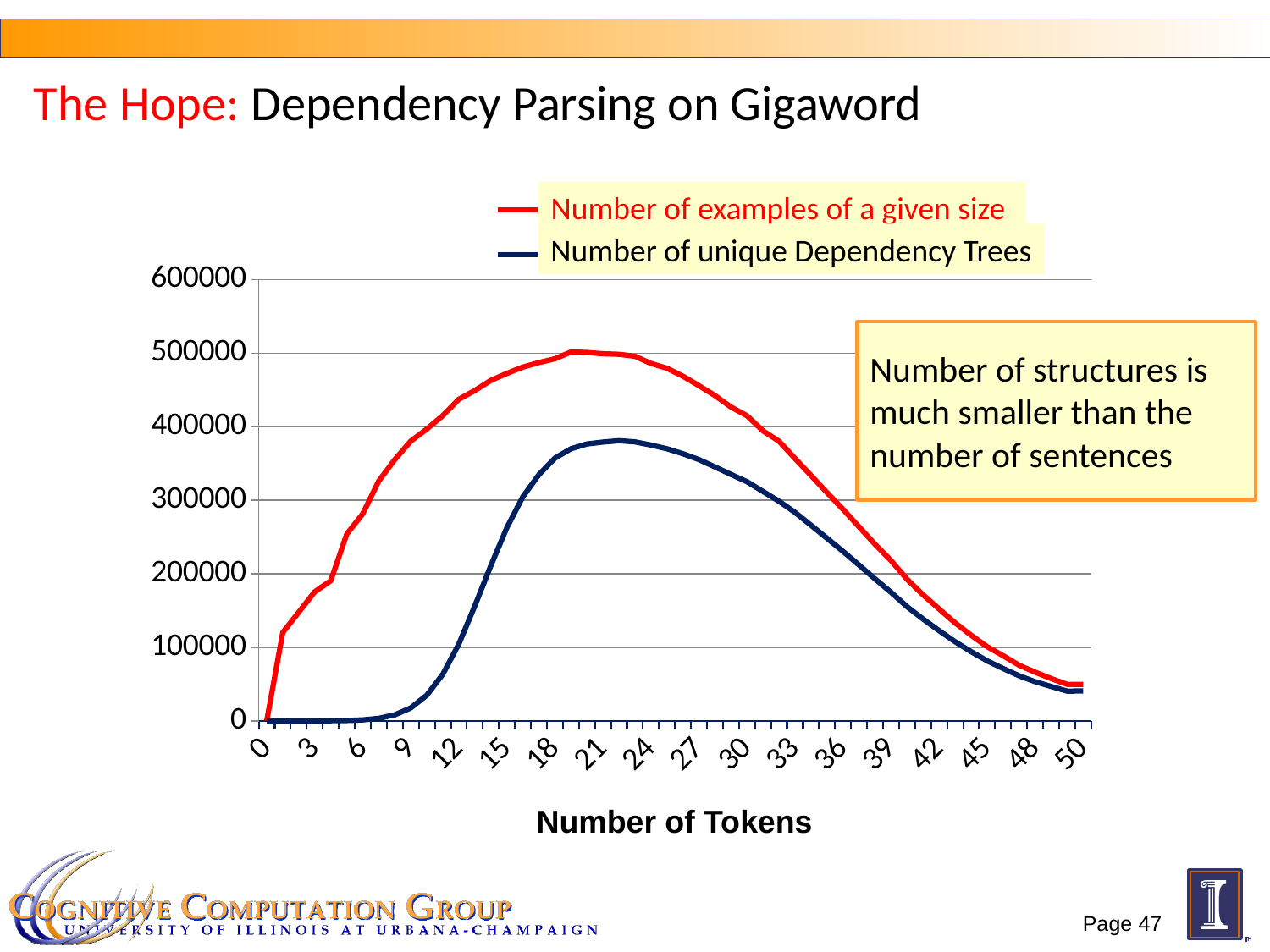
What kind of chart is shown on the slide? line chart Is the value of 'Number of examples of a given size' at 12 tokens greater or less than 400000? greater What is the title of the x axis? Number of Tokens How many series does the legend list? 2 Is the value of 'Number of examples of a given size' at 42 tokens greater or less than 100000? greater Does the 'Number of examples of a given size' line rise or fall between 27 and 50 tokens? fall Is the value of 'Number of unique Dependency Trees' at 15 tokens greater or less than 200000? greater At 21 tokens, which series has the larger value: 'Number of examples of a given size' or 'Number of unique Dependency Trees'? Number of examples of a given size Which series reaches the higher peak value? Number of examples of a given size Which series is drawn in red? Number of examples of a given size